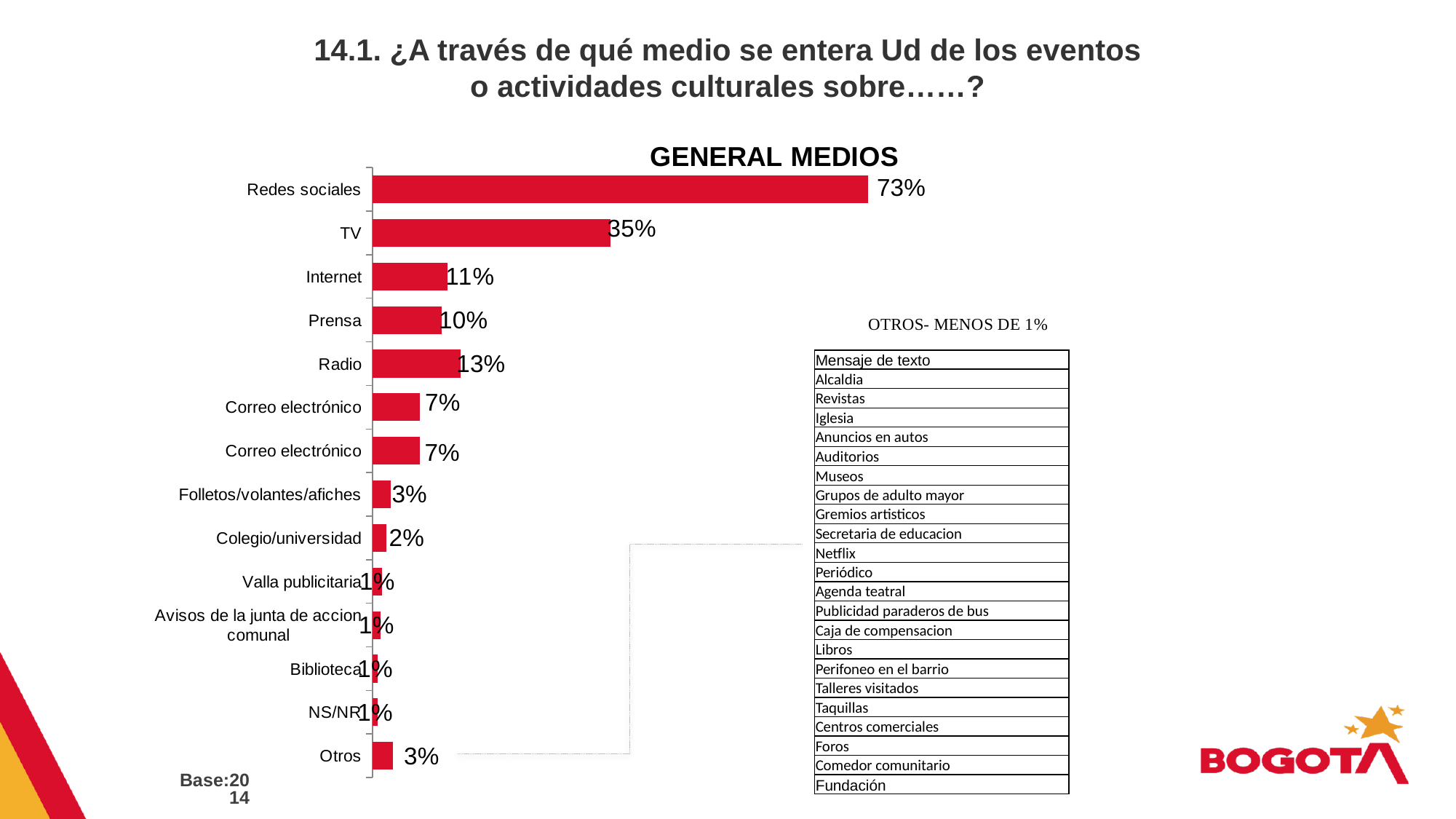
Which is larger in the GENERAL MEDIOS chart, the value for Internet or the value for Prensa? Internet What is the value for Redes sociales in the GENERAL MEDIOS chart? 73% What is the value for Prensa in the GENERAL MEDIOS chart? 10% What is the value for Folletos/volantes/afiches in the GENERAL MEDIOS chart? 3% What is the value for TV in the GENERAL MEDIOS chart? 35% What is the difference between the values for Redes sociales and TV in the GENERAL MEDIOS chart? 38% Which is larger in the GENERAL MEDIOS chart, the value for Radio or the value for Correo electrónico? Radio Which category has the highest value in the GENERAL MEDIOS chart? Redes sociales What is the difference between the values for Radio and Internet in the GENERAL MEDIOS chart? 2% What kind of chart is the GENERAL MEDIOS chart? Bar chart How many categories are shown in the GENERAL MEDIOS chart? 14 What is the value for Radio in the GENERAL MEDIOS chart? 13%